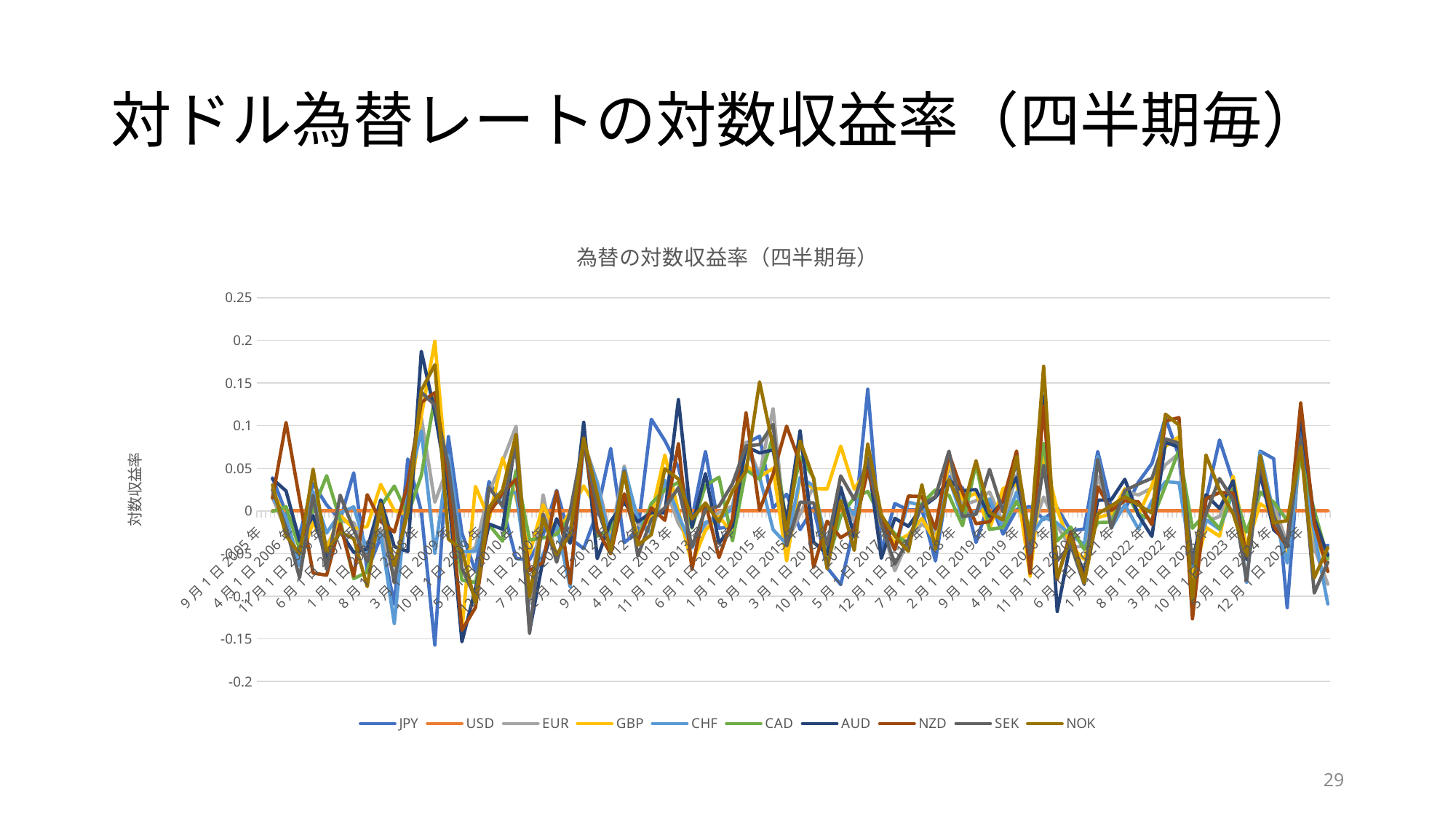
What is the label on the vertical axis of the chart? 対数収益率 What kind of chart is shown on the slide? line chart What is the lowest tick value shown on the vertical axis? -0.2 What is the title of the chart? 為替の対数収益率（四半期毎） Which series is listed first in the legend? JPY Is the peak value of the NOK line around 2020 greater or less than 0.15? greater Is the peak value of the GBP line greater or less than 0.15? greater How many series does the legend list? 10 What is the highest tick value shown on the vertical axis? 0.25